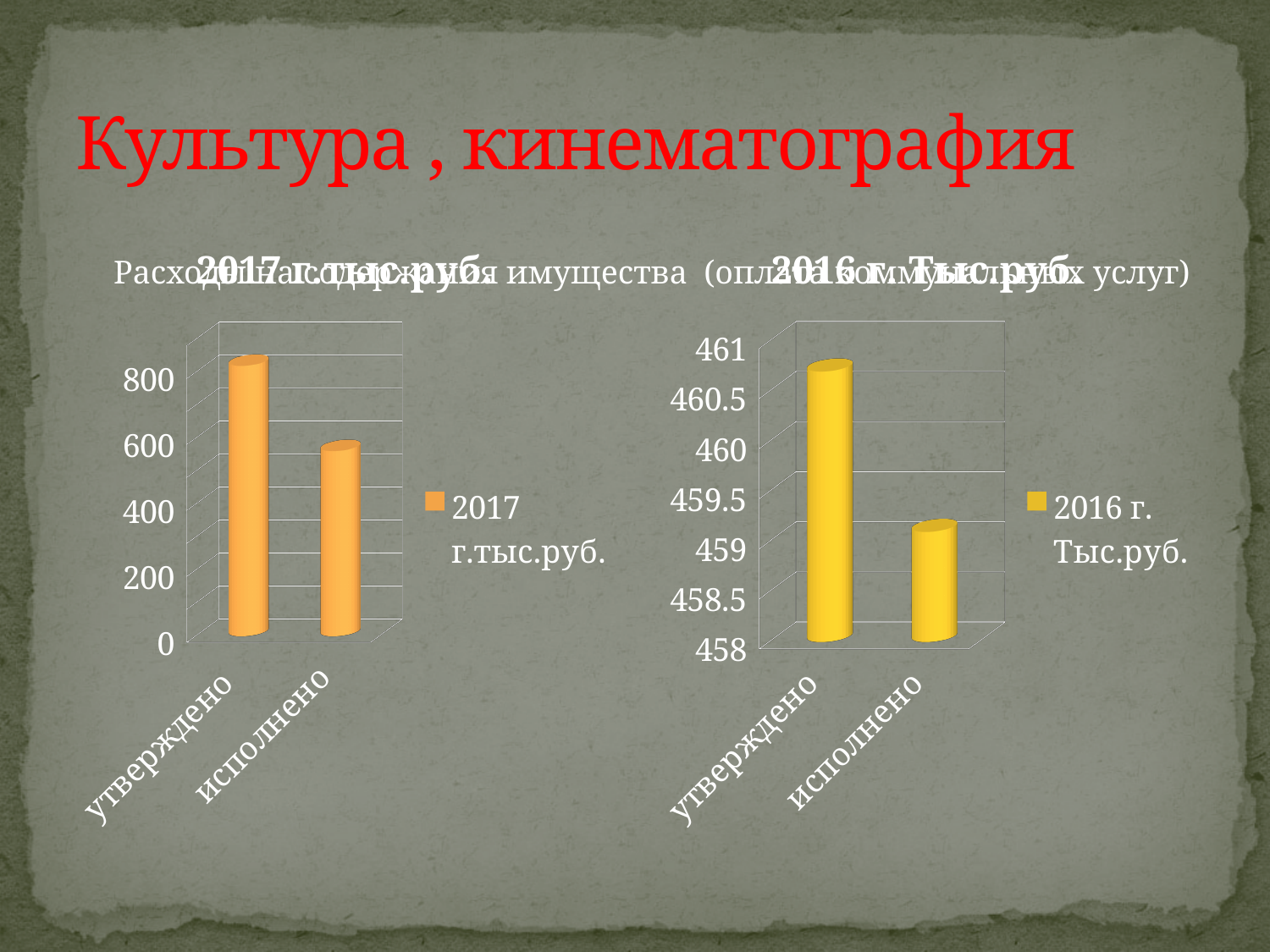
In the right chart, which is larger, утверждено or исполнено? утверждено How many series does the legend of the right chart list? 1 In the right chart, is the value for утверждено greater or less than 460.5? greater In the left chart, which category has the highest value? утверждено What is the legend entry of the right chart? 2016 г. Тыс.руб. In the left chart, is the value for исполнено greater or less than 600? less In the left chart, do the values rise or fall from утверждено to исполнено? fall How many categories does the left chart show? 2 In the left chart, is the value for утверждено greater or less than 600? greater What kind of chart is the left chart on the slide? bar chart In the right chart, which category has the lowest value? исполнено